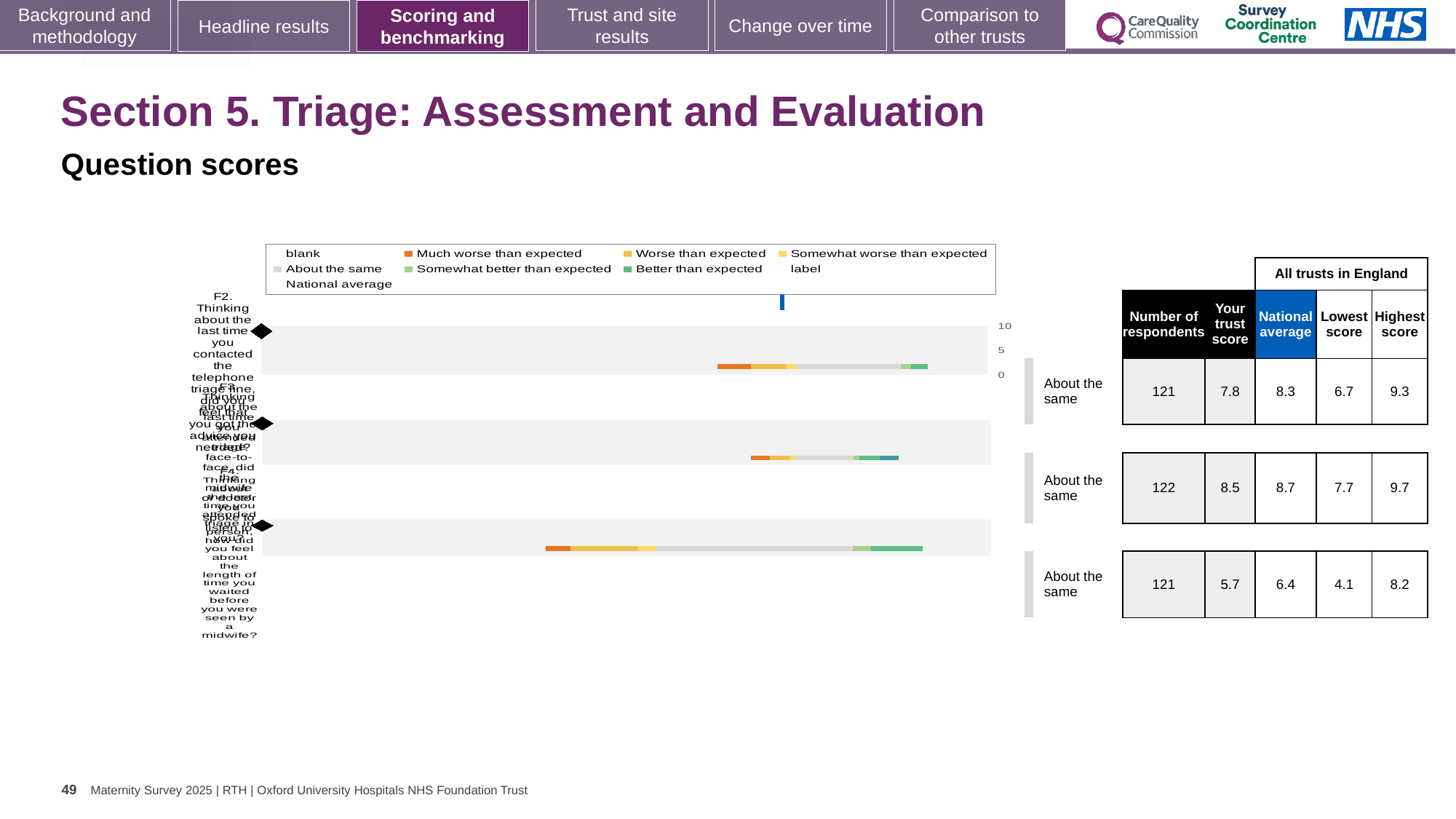
For the third (bottom) row, which is larger: Your trust score or the National average? National average In the table next to the chart, what is the 'National average' for the second row? 8.7 What kind of chart is shown on the slide? Bar chart How many question rows (bars) are plotted in the chart? 3 For the first (top) row, what is the difference between the Highest score and the Lowest score? 2.6 In the table next to the chart, what is the 'Number of respondents' for the second row? 122 Which row of the table has the highest 'Your trust score'? The second row (8.5) In the table next to the chart, what is the 'Lowest score' for the third (bottom) row? 4.1 In the table next to the chart, what is the 'Your trust score' for the first (top) row? 7.8 What benchmark category label is shown for all three question rows? About the same For the third (bottom) row, what is the difference between the National average and Your trust score? 0.7 Which row of the table has the lowest 'Your trust score'? The third row (5.7)